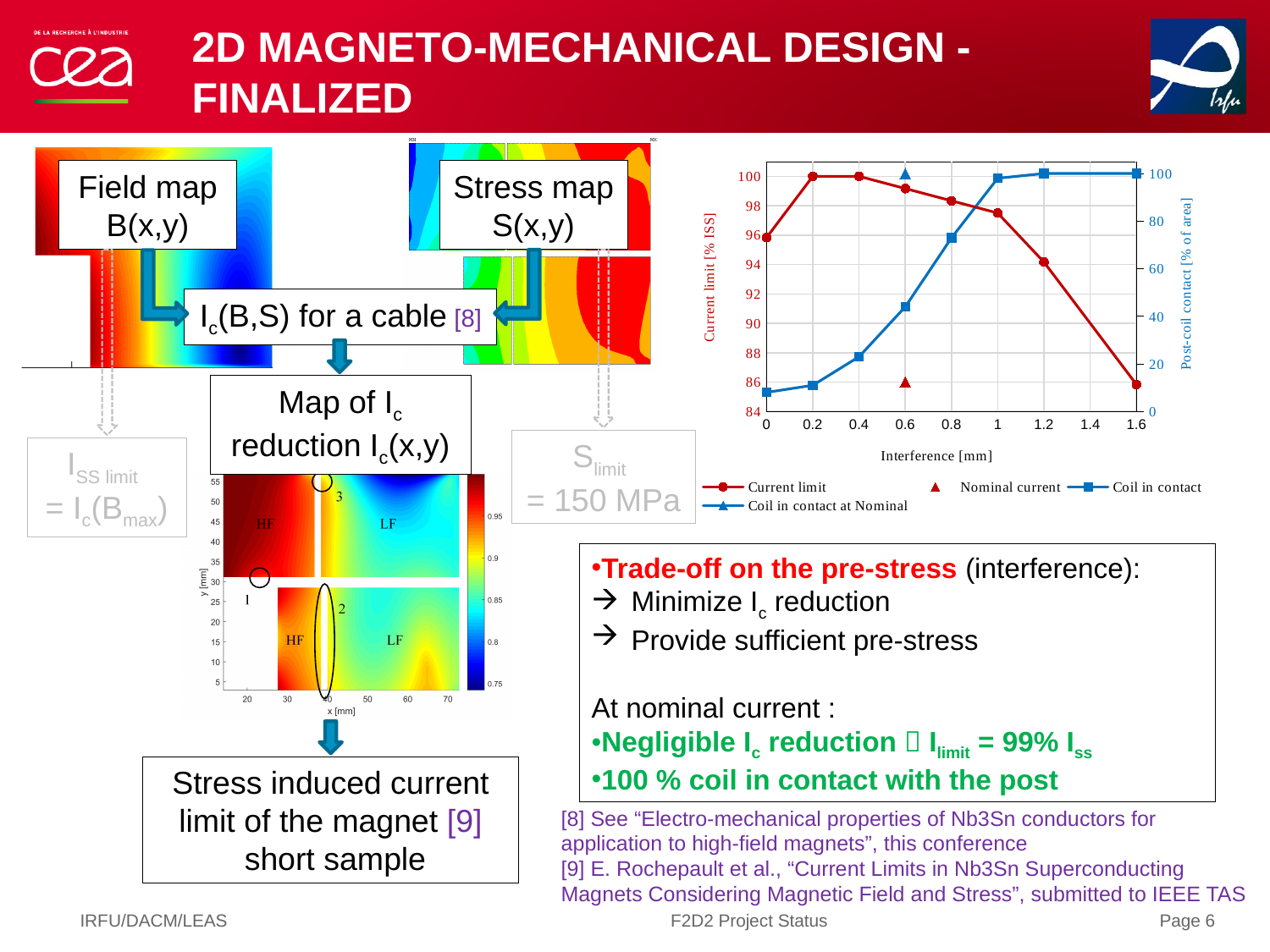
What kind of chart is shown on the right side of the slide? line chart How many series does the legend of the chart list? 4 Does the Current limit series rise or fall as interference increases from 1.0 to 1.6 mm? fall Is the Current limit value at an interference of 0.2 mm greater or less than 98? greater Is the Coil in contact value at an interference of 1.2 mm greater or less than 80? greater How many data points are plotted for the Current limit series? 8 Does the Coil in contact series rise or fall as interference increases from 0 to 1.2 mm? rise Is the Current limit value at an interference of 1.6 mm greater or less than 88? less Which is larger, the Current limit at an interference of 0.4 mm or at 1.6 mm? 0.4 mm What is the title of the right-hand y axis of the chart? Post-coil contact [% of area] What is the title of the x axis of the chart? Interference [mm]